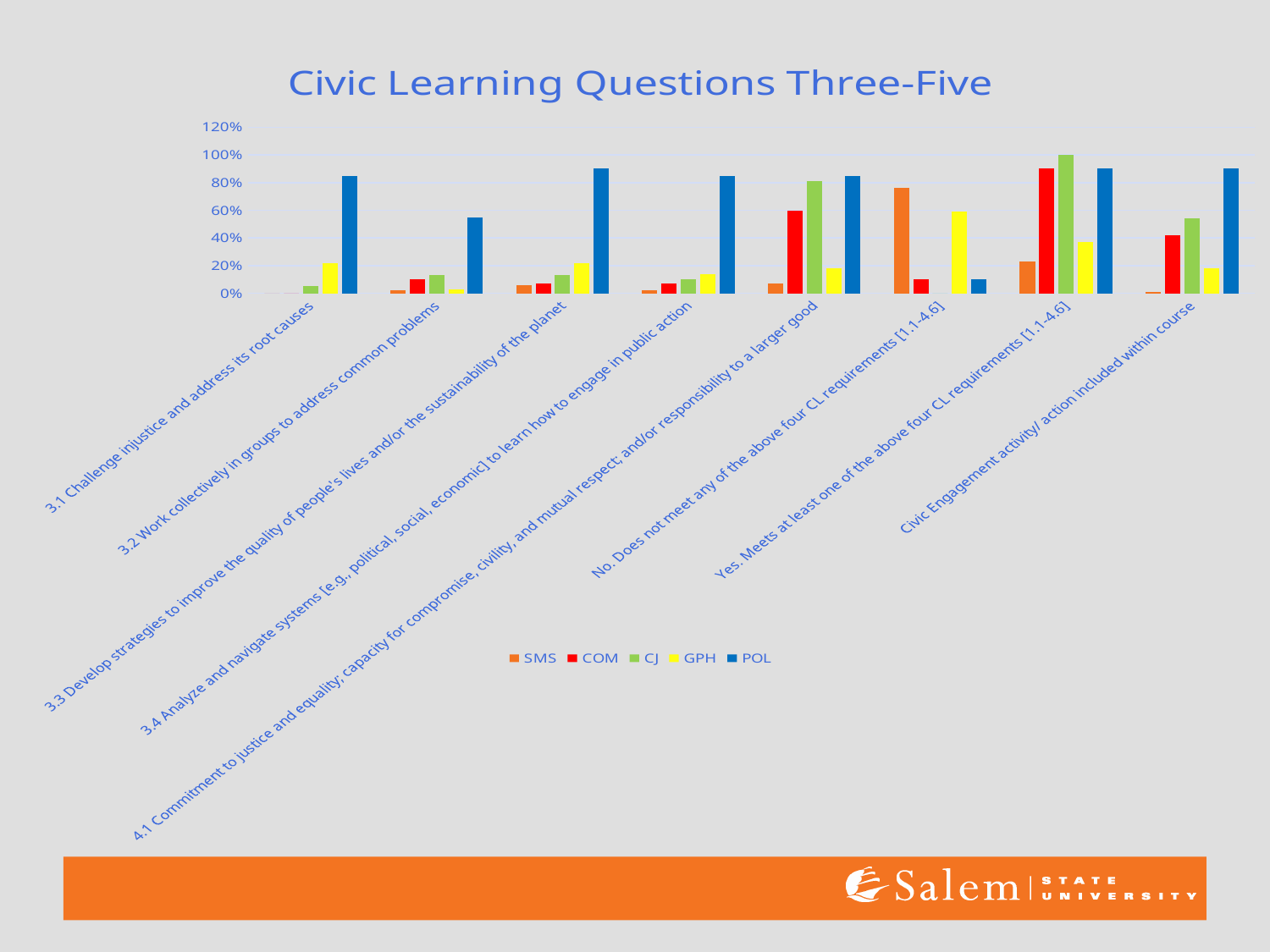
Which is larger: the POL value for '3.1 Challenge injustice and address its root causes' or the POL value for '3.2 Work collectively in groups to address common problems'? 3.1 Challenge injustice and address its root causes What is the title of the chart? Civic Learning Questions Three-Five What kind of chart is shown on the slide? bar chart Which series has the highest value for '3.1 Challenge injustice and address its root causes'? POL Is the POL value for '3.1 Challenge injustice and address its root causes' greater or less than 80%? greater Which series has the highest value for 'No. Does not meet any of the above four CL requirements [1.1-4.6]'? SMS How many categories are shown along the x axis? 8 How many series does the legend list? 5 Which series is shown in dark blue in the legend? POL Which series has the highest value for 'Yes. Meets at least one of the above four CL requirements [1.1-4.6]'? CJ Is the SMS value for 'No. Does not meet any of the above four CL requirements [1.1-4.6]' greater or less than 60%? greater Is the POL value for '3.2 Work collectively in groups to address common problems' greater or less than 60%? less